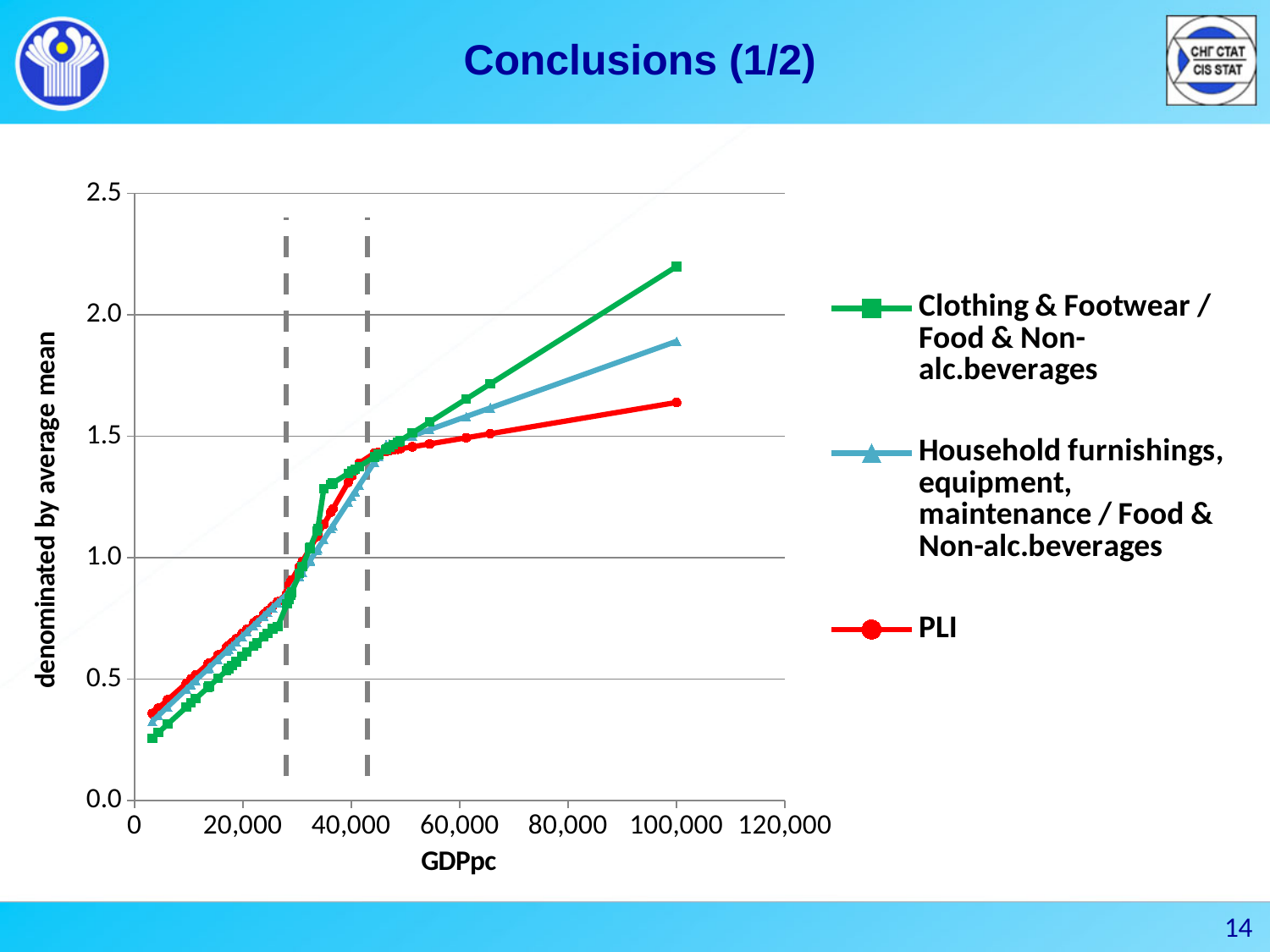
Is the value for PLI at GDPpc 100,000 greater or less than 1.5? greater Is the value for PLI at GDPpc 100,000 greater or less than 2.0? less How many series does the legend list? 3 What is the title of the y axis? denominated by average mean Is the value for Clothing & Footwear / Food & Non-alc.beverages at GDPpc 100,000 greater or less than 2.0? greater Which series is lowest at the right end of the chart (GDPpc of 100,000)? PLI At GDPpc 100,000, which is larger: the Clothing & Footwear / Food & Non-alc.beverages series or the PLI series? Clothing & Footwear / Food & Non-alc.beverages What kind of chart is shown on the slide? line chart Do the values of the PLI series rise or fall as GDPpc increases? rise What is the title of the x axis? GDPpc Which series is highest at the right end of the chart (GDPpc of 100,000)? Clothing & Footwear / Food & Non-alc.beverages